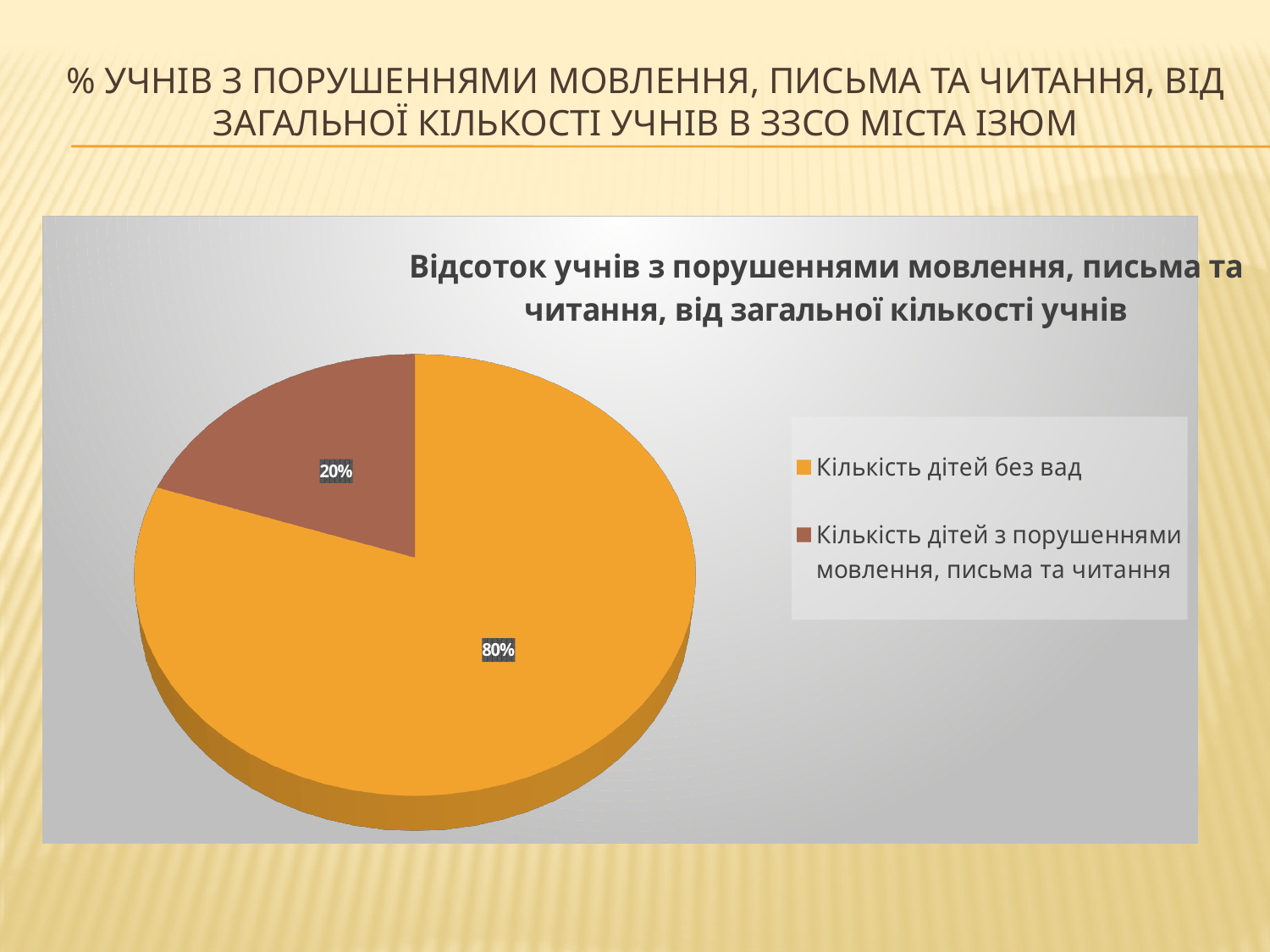
What is the difference in percentage points between the share of "Кількість дітей без вад" and "Кількість дітей з порушеннями мовлення, письма та читання"? 60% What colour is the slice for "Кількість дітей без вад"? orange What share of the pie does "Кількість дітей з порушеннями мовлення, письма та читання" represent? 20% How many slices does the pie chart have? 2 What is the title of the chart? Відсоток учнів з порушеннями мовлення, письма та читання, від загальної кількості учнів Which category has the smallest slice of the pie? Кількість дітей з порушеннями мовлення, письма та читання What kind of chart is shown on the slide? pie chart Which category has the largest slice of the pie? Кількість дітей без вад How many entries does the legend list? 2 Which is larger: the share of "Кількість дітей без вад" or the share of "Кількість дітей з порушеннями мовлення, письма та читання"? Кількість дітей без вад What share of the pie does "Кількість дітей без вад" represent? 80%